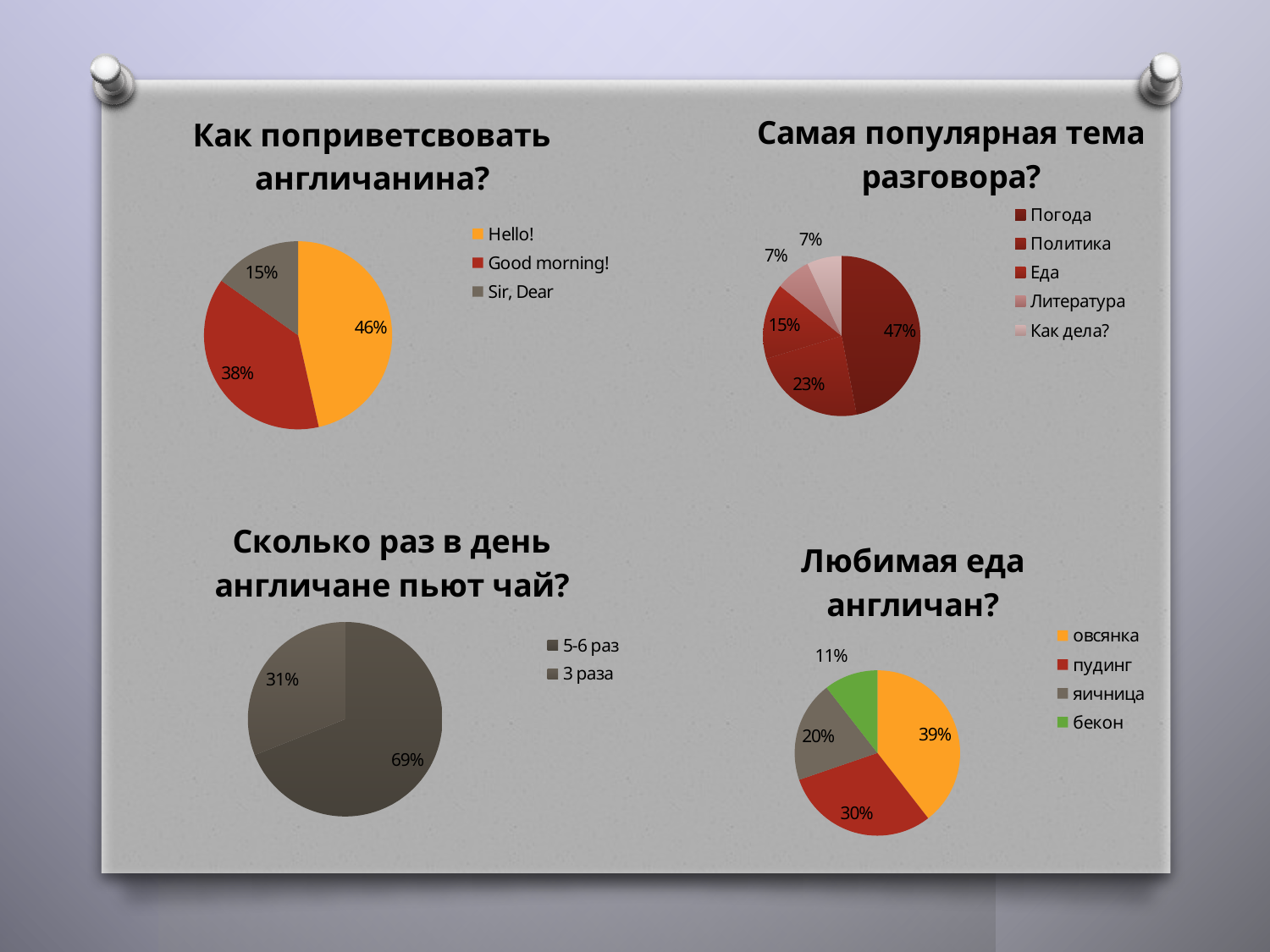
In the chart titled "Как поприветсвовать англичанина?", what share does "Hello!" have? 46% In the chart titled "Любимая еда англичан?", what colour is the "бекон" slice? Green In the chart titled "Как поприветсвовать англичанина?", what is the difference between the shares of "Hello!" and "Good morning!"? 8% In the chart titled "Самая популярная тема разговора?", what share does "Литература" have? 7% In the chart titled "Самая популярная тема разговора?", which is larger, "Политика" or "Еда"? Политика In the chart titled "Самая популярная тема разговора?", how many categories does the legend list? 5 In the chart titled "Любимая еда англичан?", which food has the largest share? овсянка In the chart titled "Самая популярная тема разговора?", what share does "Погода" have? 47% In the chart titled "Любимая еда англичан?", what share does "пудинг" have? 30% In the chart titled "Сколько раз в день англичане пьют чай?", what share does "5-6 раз" have? 69% What kind of chart is the one titled "Сколько раз в день англичане пьют чай?"? Pie chart In the chart titled "Как поприветсвовать англичанина?", which greeting has the smallest share? Sir, Dear